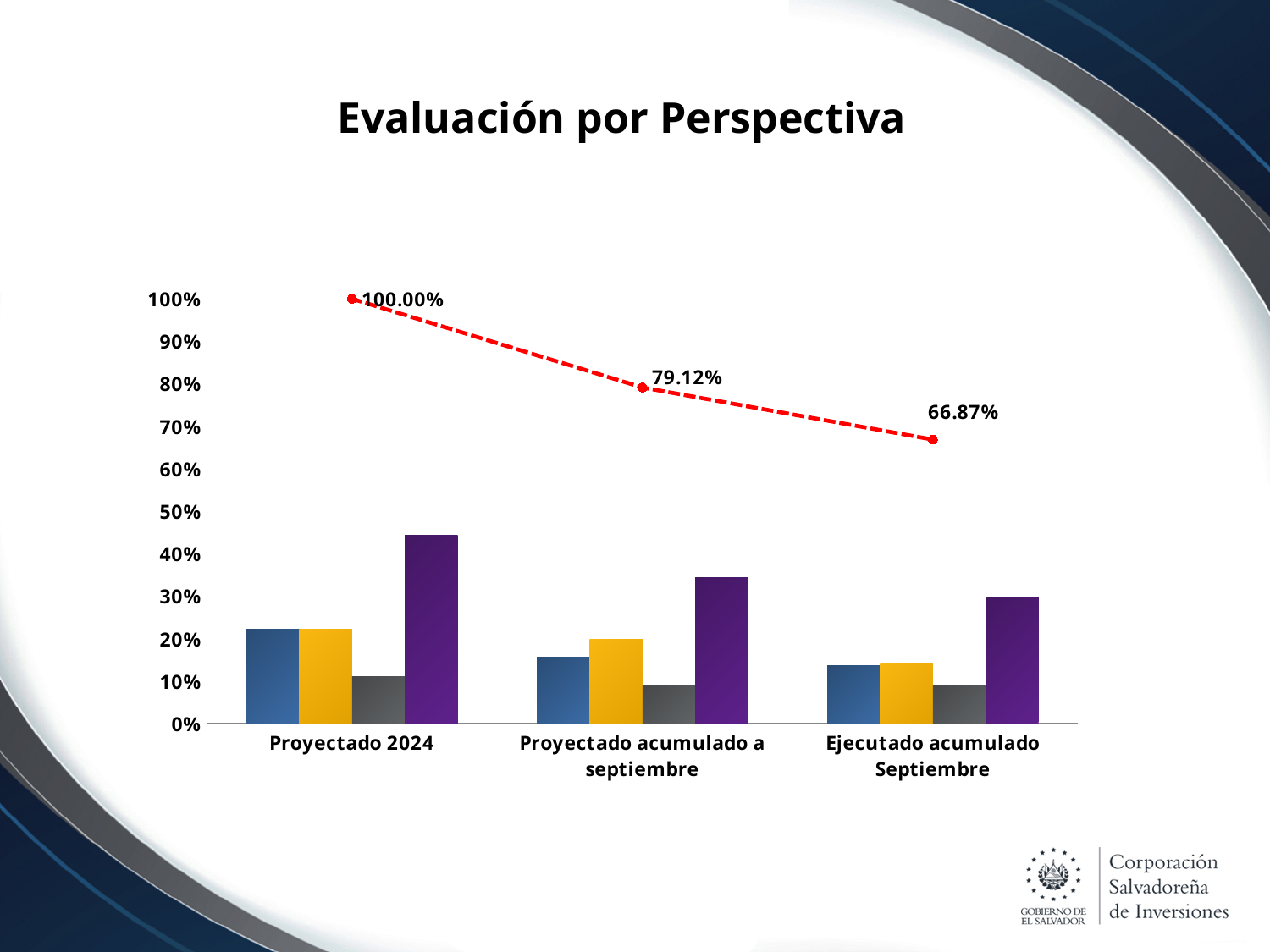
Is the value of the purple bar for Proyectado 2024 greater or less than 40%? greater What value does the dashed line show for Ejecutado acumulado Septiembre? 66.87% What value does the dashed line show for Proyectado acumulado a septiembre? 79.12% For which category is the dashed line value highest? Proyectado 2024 Is the value of the dark grey bar for Proyectado 2024 greater or less than 20%? less What is the difference between the line values for Proyectado 2024 and Proyectado acumulado a septiembre? 20.88% For which category is the dashed line value lowest? Ejecutado acumulado Septiembre What is the title of the chart? Evaluación por Perspectiva Does the dashed line rise or fall from left to right across the categories? It falls What value does the dashed line show for Proyectado 2024? 100.00% How many categories are shown on the x axis? 3 What is the difference between the line values for Proyectado acumulado a septiembre and Ejecutado acumulado Septiembre? 12.25%